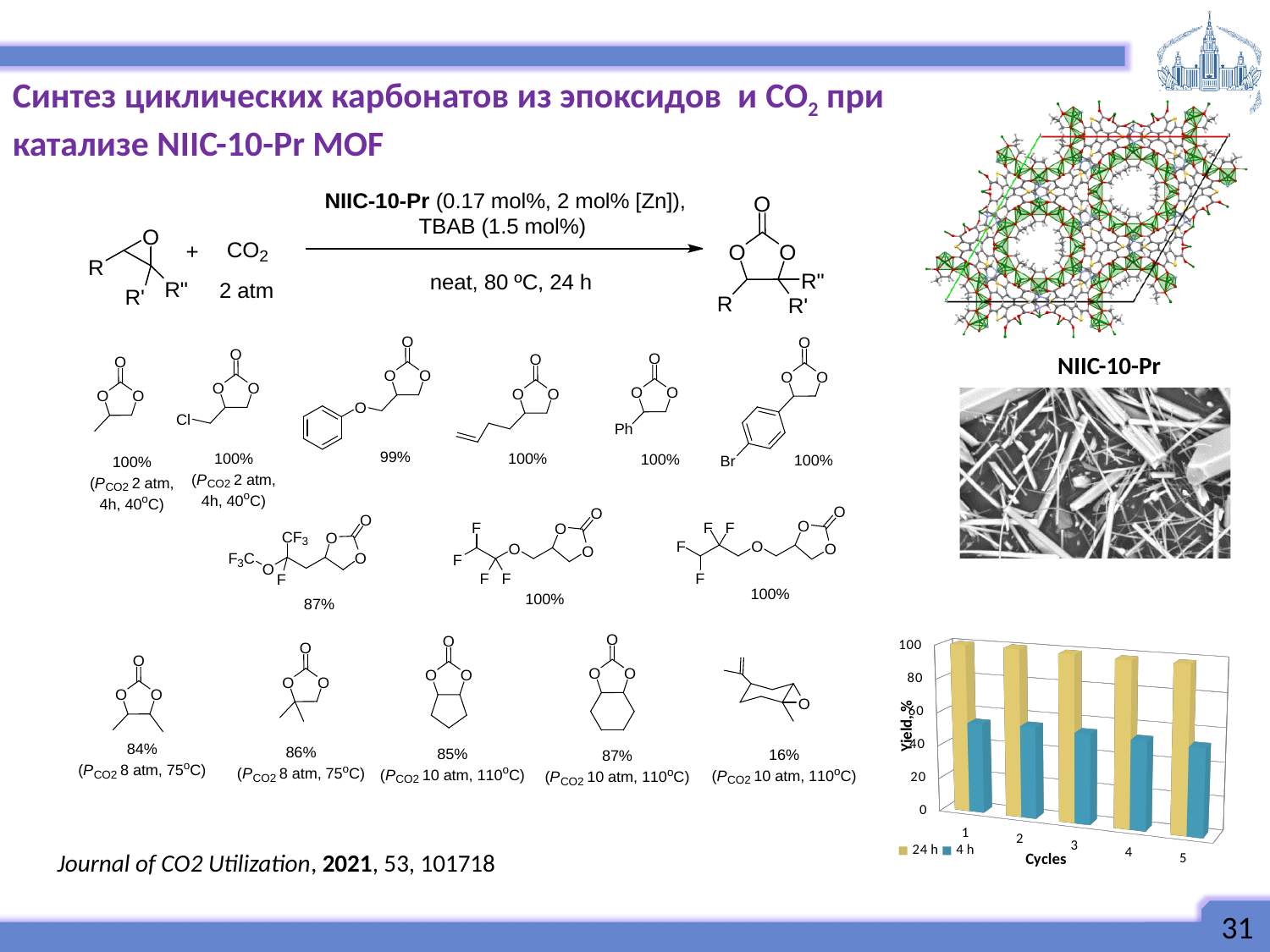
In the bar chart, do the 4 h yields rise or fall from cycle 1 to cycle 5? fall What kind of chart is shown at the bottom right of the slide? bar chart In the bar chart, which series has the larger value at cycle 3, 24 h or 4 h? 24 h How many cycles are plotted on the x axis of the bar chart? 5 In the bar chart, which cycle has the lowest 4 h yield? 5 In the bar chart, do the 24 h yields rise or fall as the cycle number increases? fall What is the label of the vertical axis of the bar chart? Yield, % How many series does the legend of the bar chart list? 2 In the bar chart, is the 4 h value for cycle 1 greater or less than 40? greater What are the two series named in the legend of the bar chart? 24 h and 4 h In the bar chart, is the 24 h value for cycle 1 greater or less than 80? greater In the bar chart, is the 4 h value for cycle 5 greater or less than 60? less